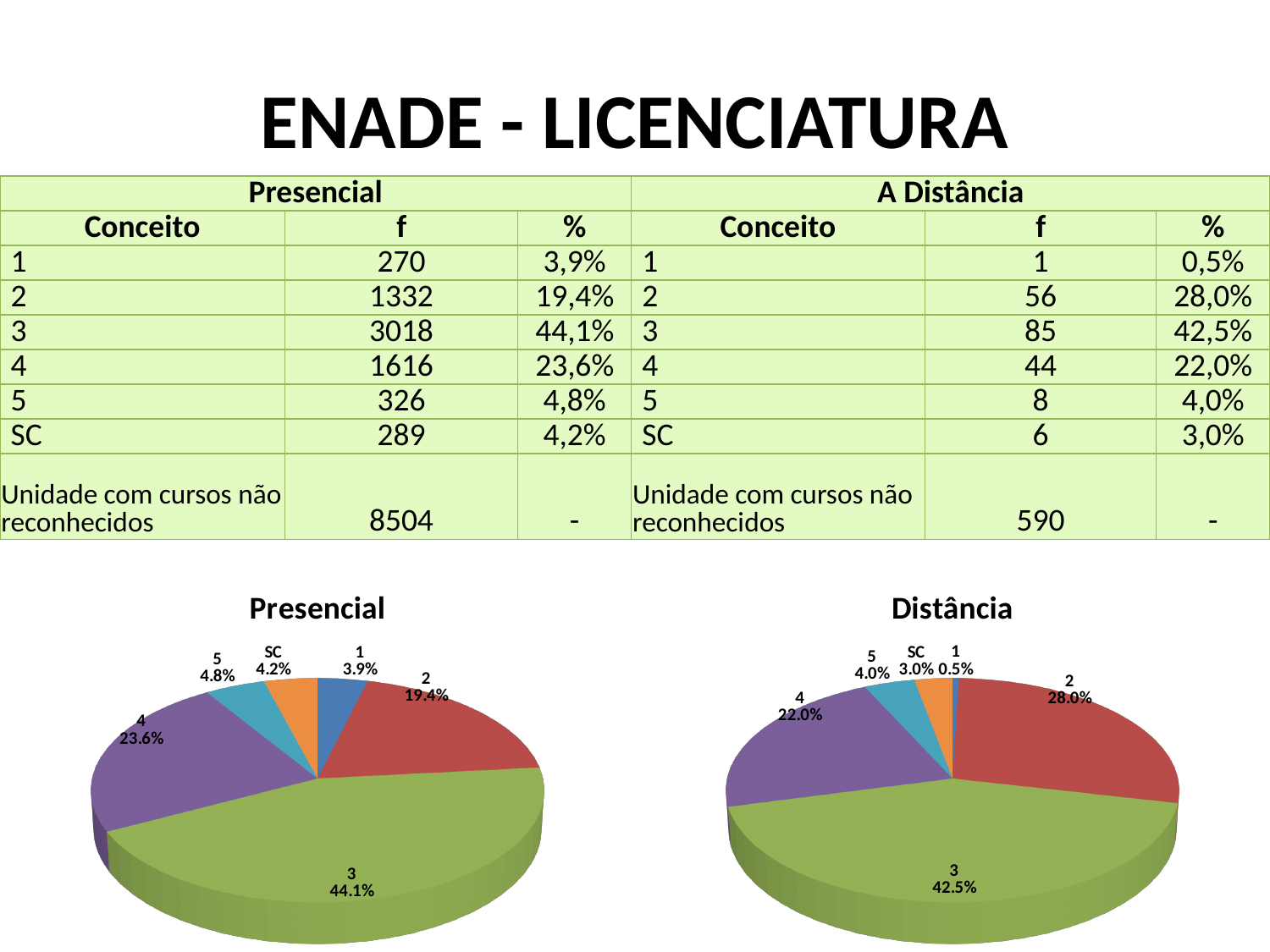
In the Presencial pie chart, what share does category 3 have? 44.1% What is the title of the pie chart on the right of the slide? Distância In the Presencial pie chart, which category has the largest slice? 3 In the Distância pie chart, what share does category 2 have? 28.0% In the Presencial pie chart, which category has the smallest slice? 1 In the Presencial pie chart, which is larger, the slice for category 2 or the slice for category 4? 4 In the Presencial pie chart, what share does the SC slice have? 4.2% In the Distância pie chart, what is the difference between the shares of category 3 and category 4? 20.5% What type of chart is the Presencial chart? pie chart How many slices does the Distância pie chart have? 6 In the Distância pie chart, which category has the smallest slice? 1